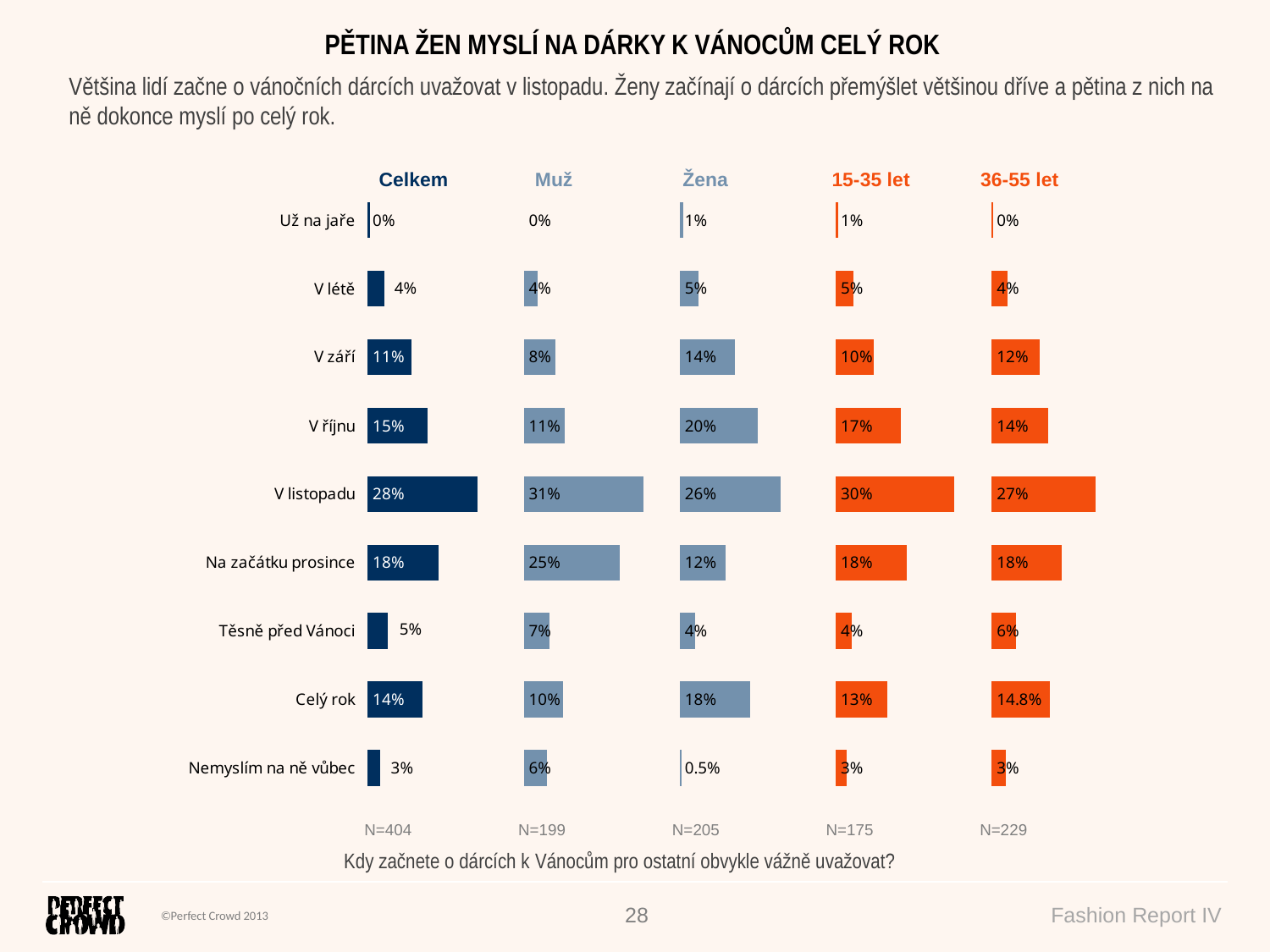
In the Žena chart, what is the value for Celý rok? 18% In the Muž chart, which category has the highest value? V listopadu Which is larger in the Muž chart: Na začátku prosince or V říjnu? Na začátku prosince In the Žena chart, what is the value for Nemyslím na ně vůbec? 0.5% In the 36-55 let chart, what is the value for Celý rok? 14.8% What is the sample size (N) shown under the Žena chart? N=205 In the 15-35 let chart, what is the difference between V listopadu and Na začátku prosince? 12% In the Celkem chart, what is the value for V listopadu? 28% What kind of chart is used for the Celkem column? Bar chart How many separate charts (columns) are shown on the slide? 5 How many categories are shown in the Celkem chart? 9 In the Žena chart, which category has the lowest value? Nemyslím na ně vůbec